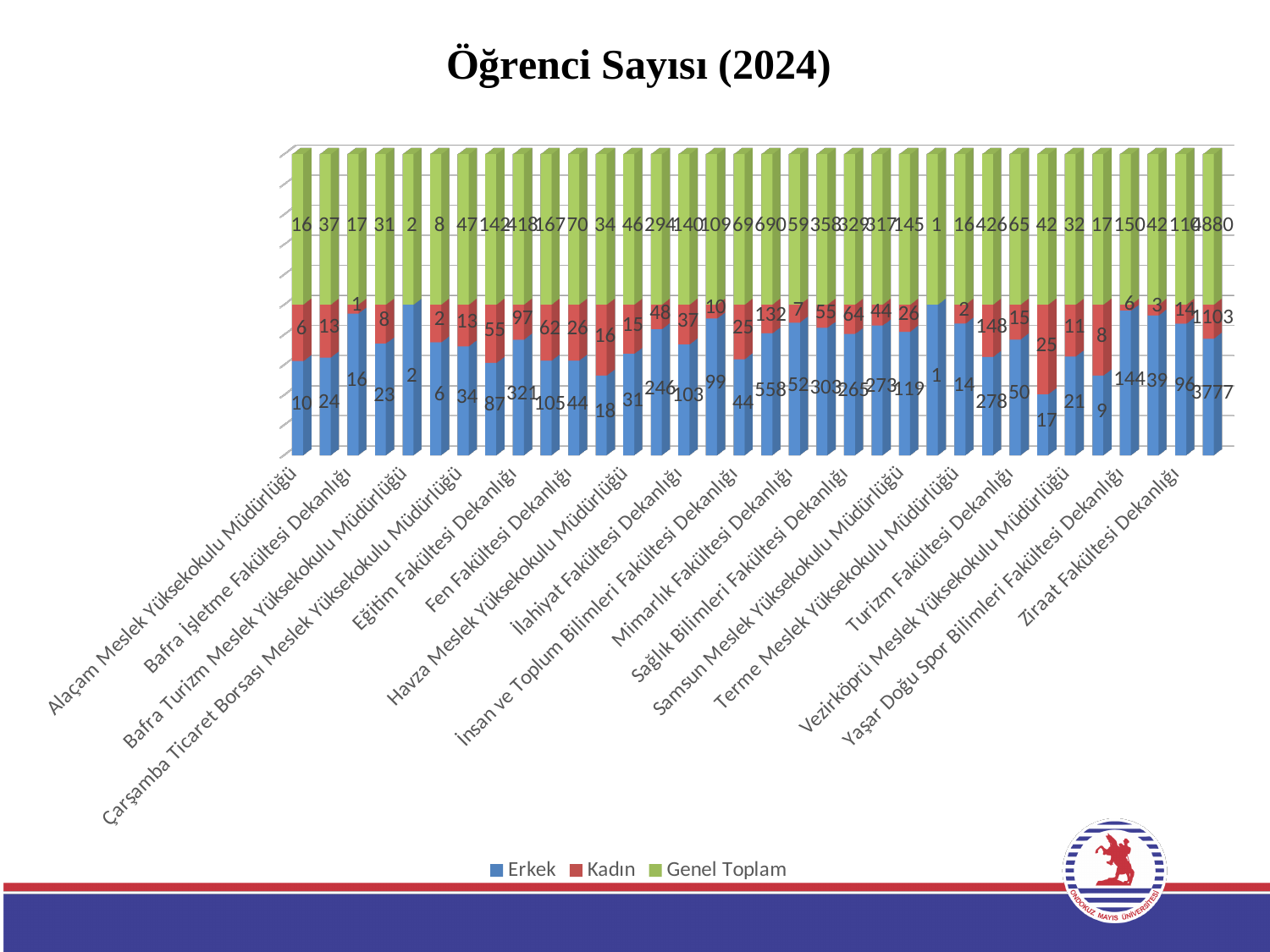
For Alaçam Meslek Yüksekokulu Müdürlüğü, which is larger, the Erkek value or the Kadın value? Erkek What kind of chart is shown on the slide? bar chart What is the Kadın value for Alaçam Meslek Yüksekokulu Müdürlüğü? 6 What are the series names listed in the legend? Erkek, Kadın, Genel Toplam For Alaçam Meslek Yüksekokulu Müdürlüğü, what is the difference between the Erkek value and the Kadın value? 4 What is the title of the chart? Öğrenci Sayısı (2024) What is the Genel Toplam value for Alaçam Meslek Yüksekokulu Müdürlüğü? 16 How many series does the legend list? 3 What is the Kadın value labelled on the rightmost bar of the chart? 1103 What is the Erkek value labelled on the rightmost bar of the chart? 3777 What is the Erkek value for Alaçam Meslek Yüksekokulu Müdürlüğü? 10 What is the largest Genel Toplam value labelled on the chart? 4880